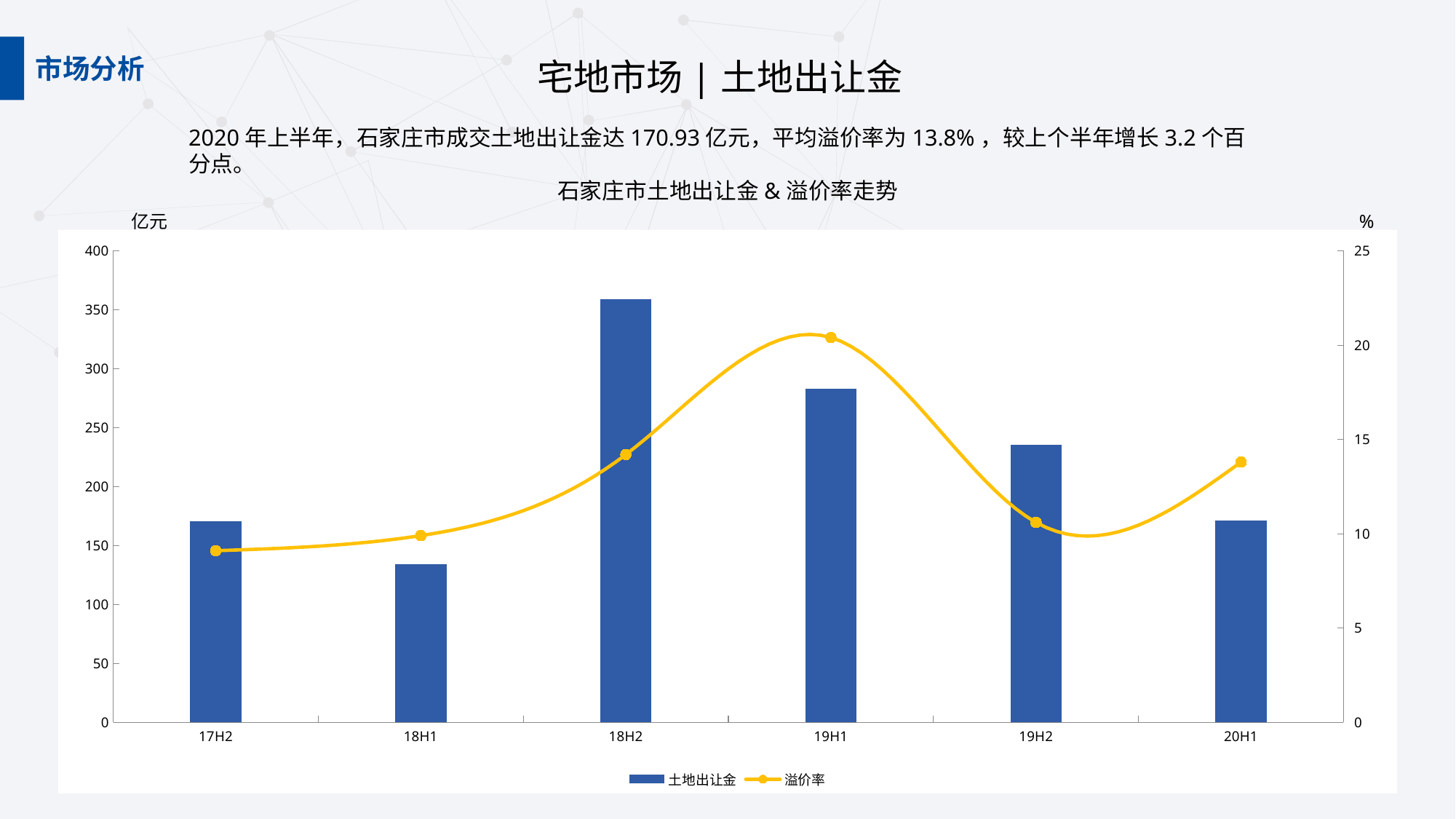
Which period has the lowest 土地出让金 bar? 18H1 Does the 溢价率 line rise or fall from 17H2 to 19H1? rises Which is larger, the 土地出让金 bar for 19H1 or for 19H2? 19H1 How many periods are shown on the x axis of the chart? 6 What is the title of the chart? 石家庄市土地出让金 & 溢价率走势 Which period has the highest 溢价率 point on the line? 19H1 Is the 土地出让金 value for 18H1 greater or less than 150? less Which period has the highest 土地出让金 bar? 18H2 Is the 溢价率 value for 19H1 greater or less than 15? greater What kind of chart is shown on the slide? A combined bar and line chart How many series does the chart legend list? 2 Is the 土地出让金 value for 18H2 greater or less than 300? greater